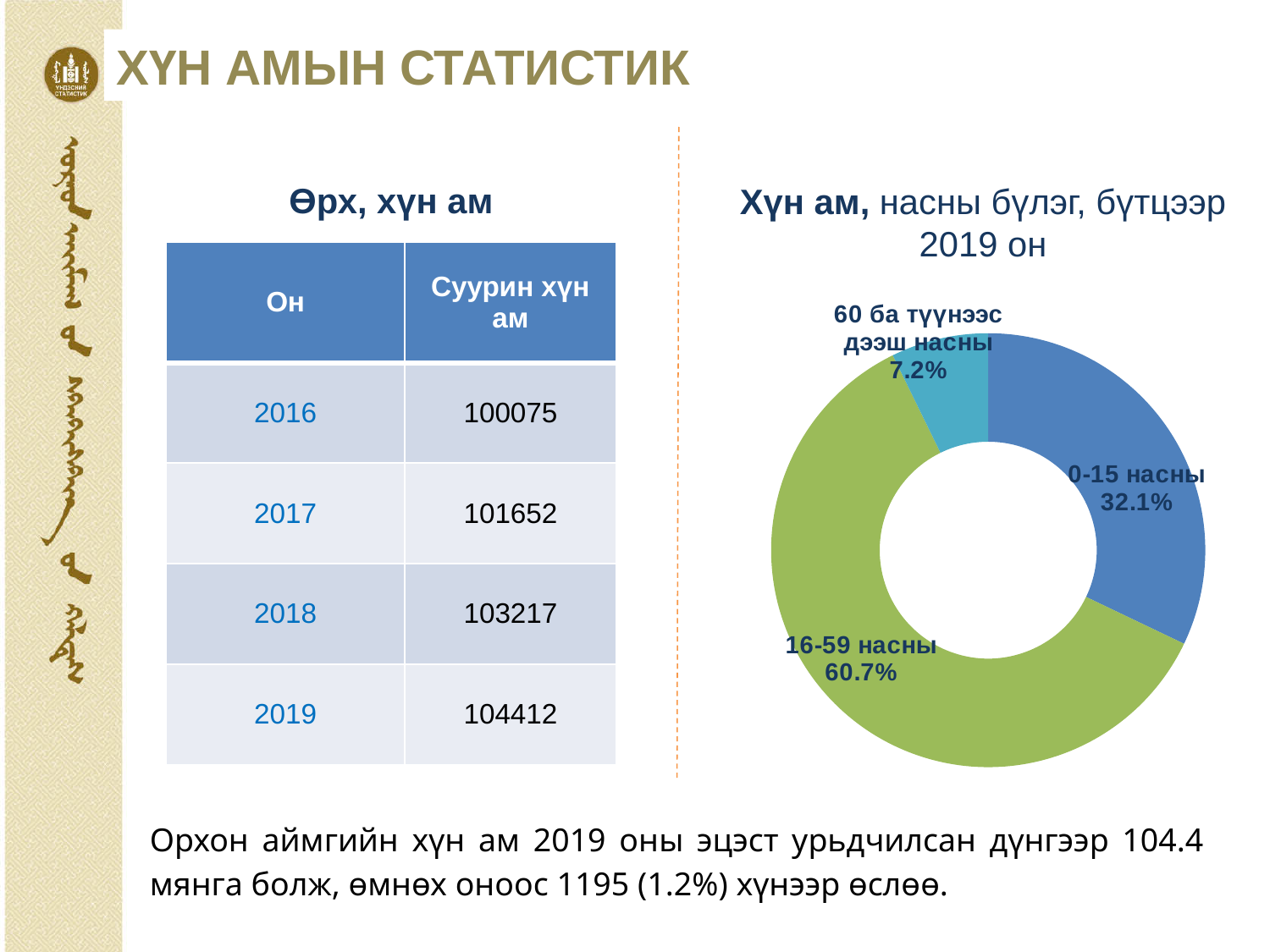
In the doughnut chart, is the share of the 16-59 насны group greater or less than 50%? greater Which age group has the largest share in the doughnut chart? 16-59 насны What colour is the 16-59 насны slice in the doughnut chart? Green How many age groups are shown in the doughnut chart? 3 What share of the population is in the 0-15 насны group in the doughnut chart? 32.1% What share of the population is in the 16-59 насны group in the doughnut chart? 60.7% Which age group has the smallest share in the doughnut chart? 60 ба түүнээс дээш насны What is the title of the chart on the right side of the slide? Хүн ам, насны бүлэг, бүтцээр 2019 он In the doughnut chart, which is larger: the share of 0-15 насны or the share of 60 ба түүнээс дээш насны? 0-15 насны What type of chart is shown on the right side of the slide? Doughnut (pie) chart In the doughnut chart, how many percentage points larger is the 16-59 насны share than the 0-15 насны share? 28.6 What share of the population is in the 60 ба түүнээс дээш насны group in the doughnut chart? 7.2%